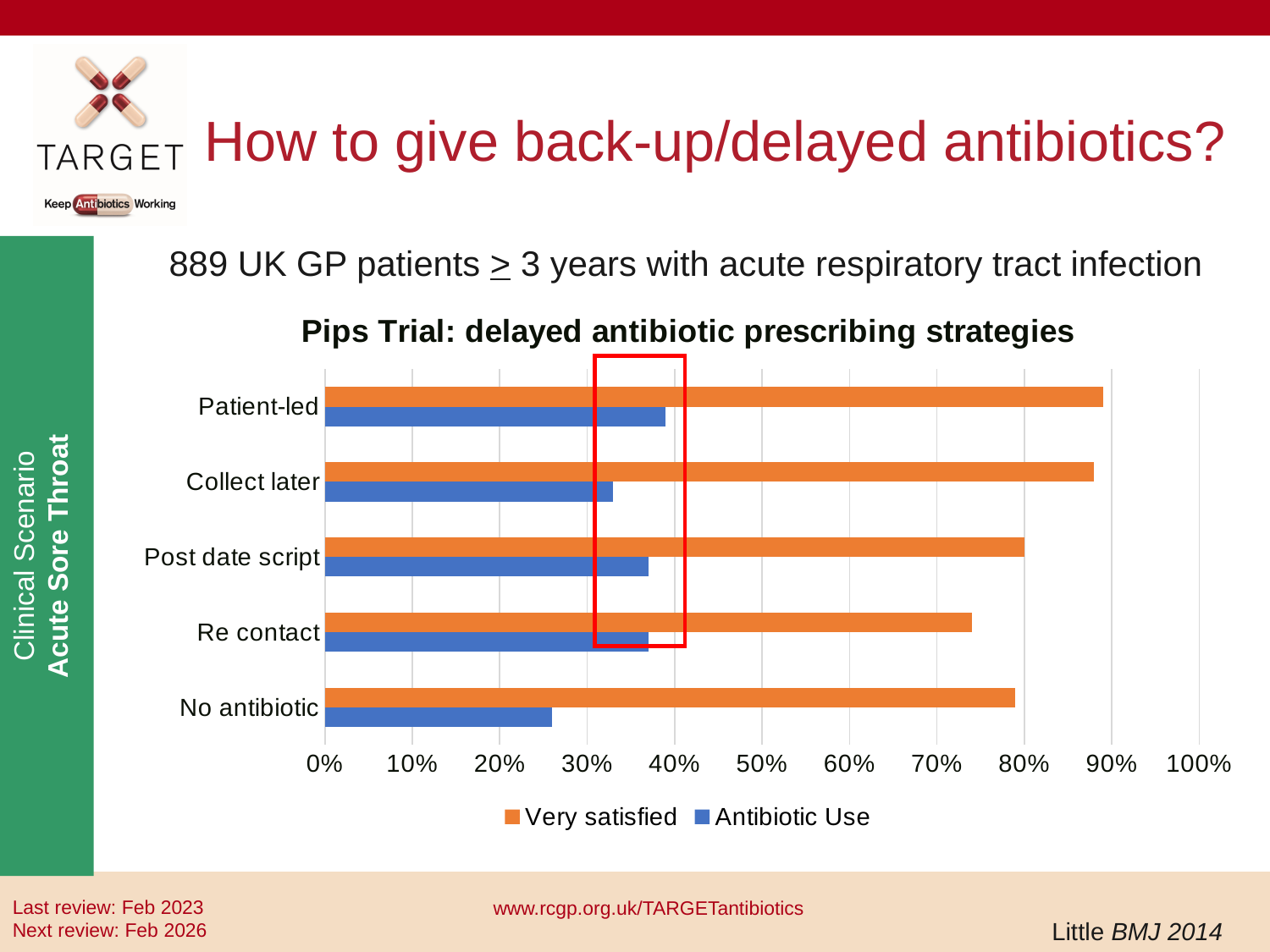
What is the title of the chart? Pips Trial: delayed antibiotic prescribing strategies For Collect later, which is larger: Very satisfied or Antibiotic Use? Very satisfied Is the Very satisfied value for Re contact greater or less than 80%? less Which series is shown in orange? Very satisfied What kind of chart is shown on the slide? Bar chart Which strategy has the lowest Antibiotic Use value? No antibiotic How many prescribing strategies (categories) are shown on the chart? 5 Which has the higher Very satisfied value, Patient-led or Re contact? Patient-led Is the Very satisfied value for Patient-led greater or less than 80%? greater Is the Antibiotic Use value for No antibiotic greater or less than 30%? less How many series does the chart legend list? 2 Which strategy has the lowest Very satisfied value? Re contact